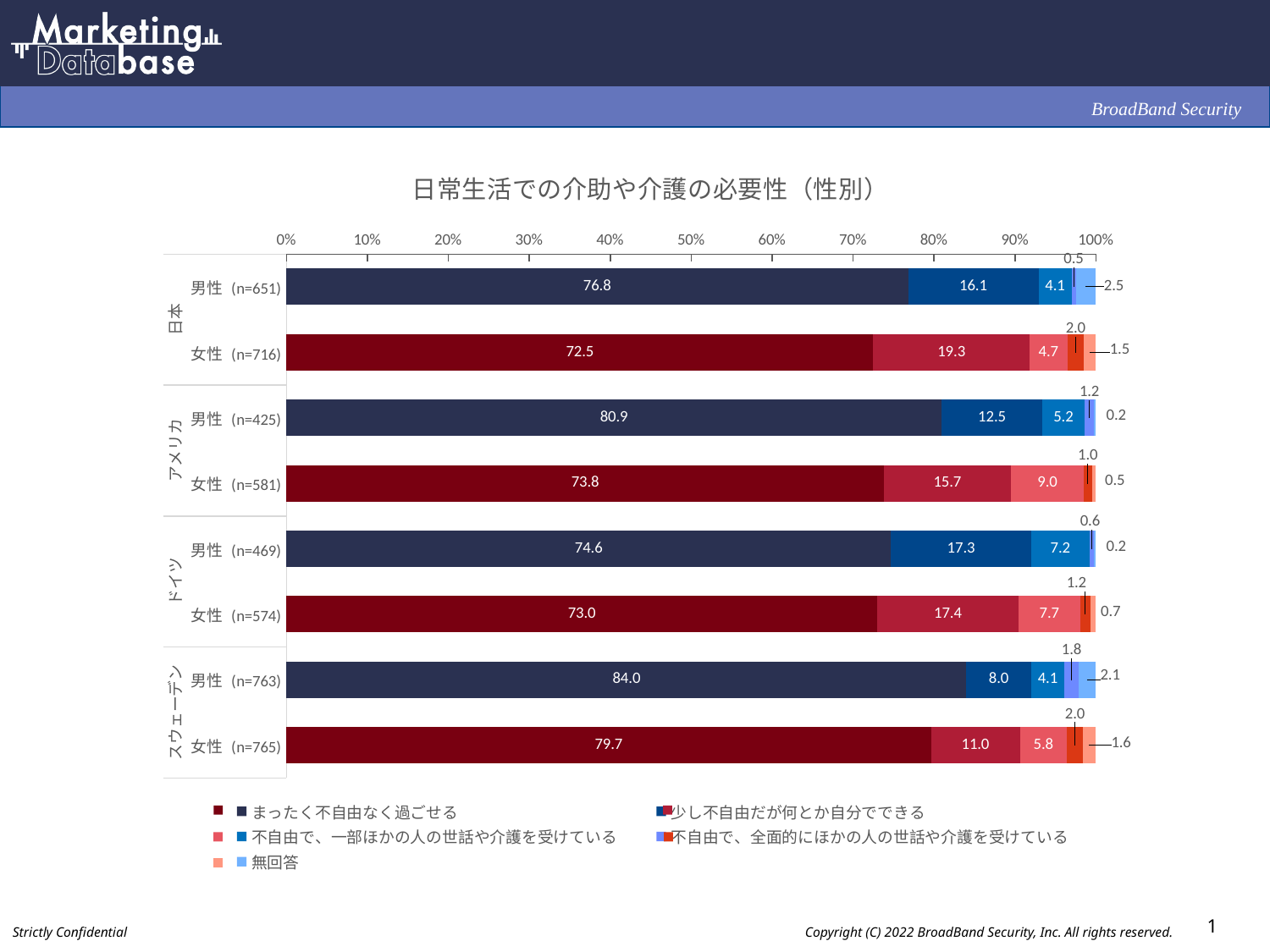
How many category bars are shown in the chart? 8 What is the title of the chart? 日常生活での介助や介護の必要性（性別） Which is larger for 少し不自由だが何とか自分でできる: 日本 女性 (n=716) or アメリカ 男性 (n=425)? 日本 女性 (n=716) What is the difference in まったく不自由なく過ごせる between 日本 男性 (n=651) and 日本 女性 (n=716)? 4.3 What is the value of 少し不自由だが何とか自分でできる for アメリカ 女性 (n=581)? 15.7 What is the value of 無回答 for スウェーデン 男性 (n=763)? 2.1 What kind of chart is shown on the slide? Stacked bar chart Which category has the lowest value for まったく不自由なく過ごせる? 日本 女性 (n=716) How many series does the legend list? 5 What is the value of まったく不自由なく過ごせる for 日本 男性 (n=651)? 76.8 Which category has the highest value for まったく不自由なく過ごせる? スウェーデン 男性 (n=763) What is the value of 不自由で、一部ほかの人の世話や介護を受けている for ドイツ 女性 (n=574)? 7.7